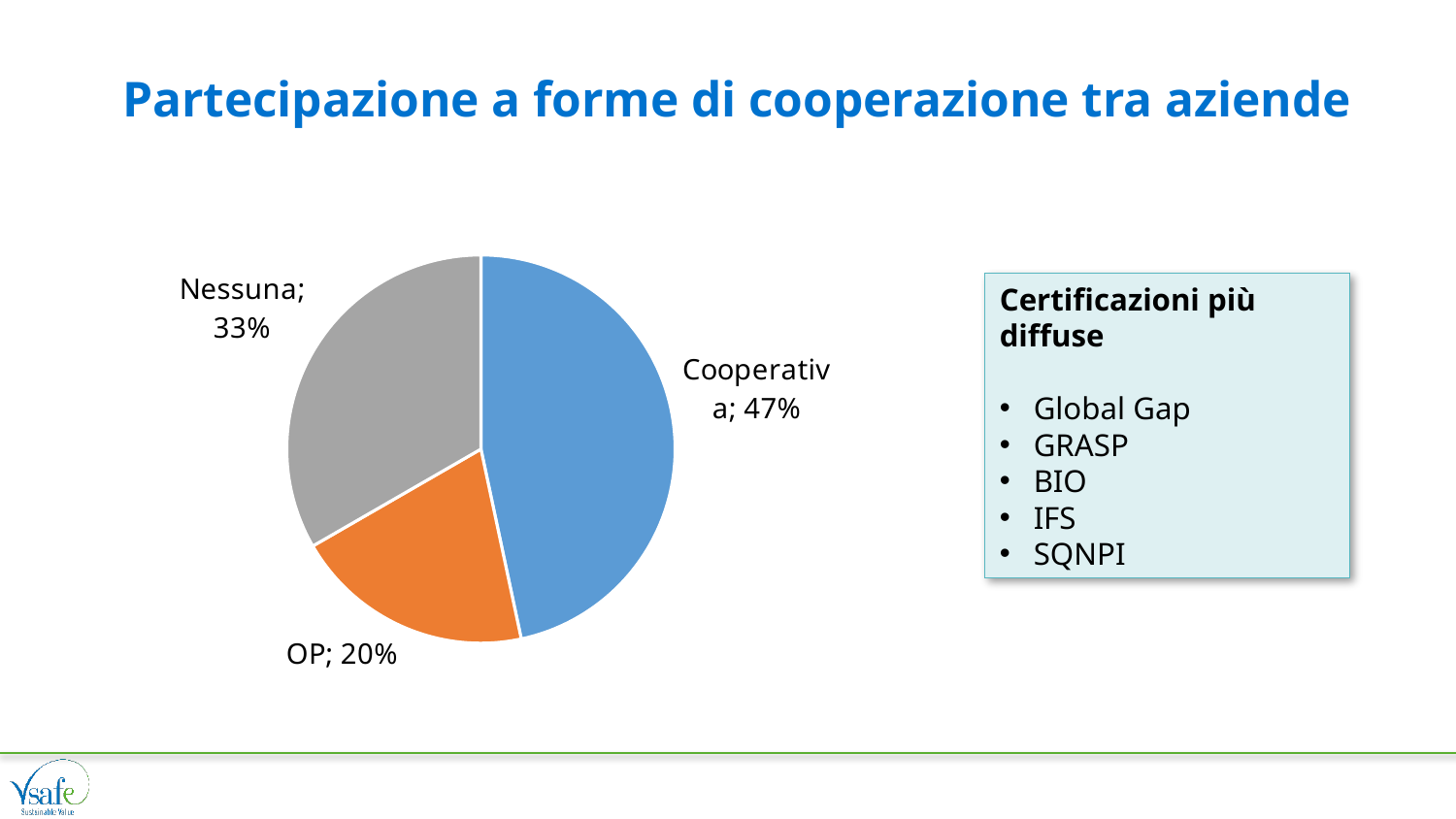
What colour is the Cooperativa slice of the pie? blue Which slice of the pie is the largest? Cooperativa What is the difference in percentage points between Nessuna and OP? 13 What is the difference in percentage points between Cooperativa and Nessuna? 14 What share of the pie does OP have? 20% What share of the pie does Nessuna have? 33% Which is larger, the share for Nessuna or the share for OP? Nessuna What kind of chart is shown on the slide? pie chart Which slice of the pie is the smallest? OP What is the title of the slide containing the pie chart? Partecipazione a forme di cooperazione tra aziende How many slices does the pie chart have? 3 What share of the pie does Cooperativa have? 47%